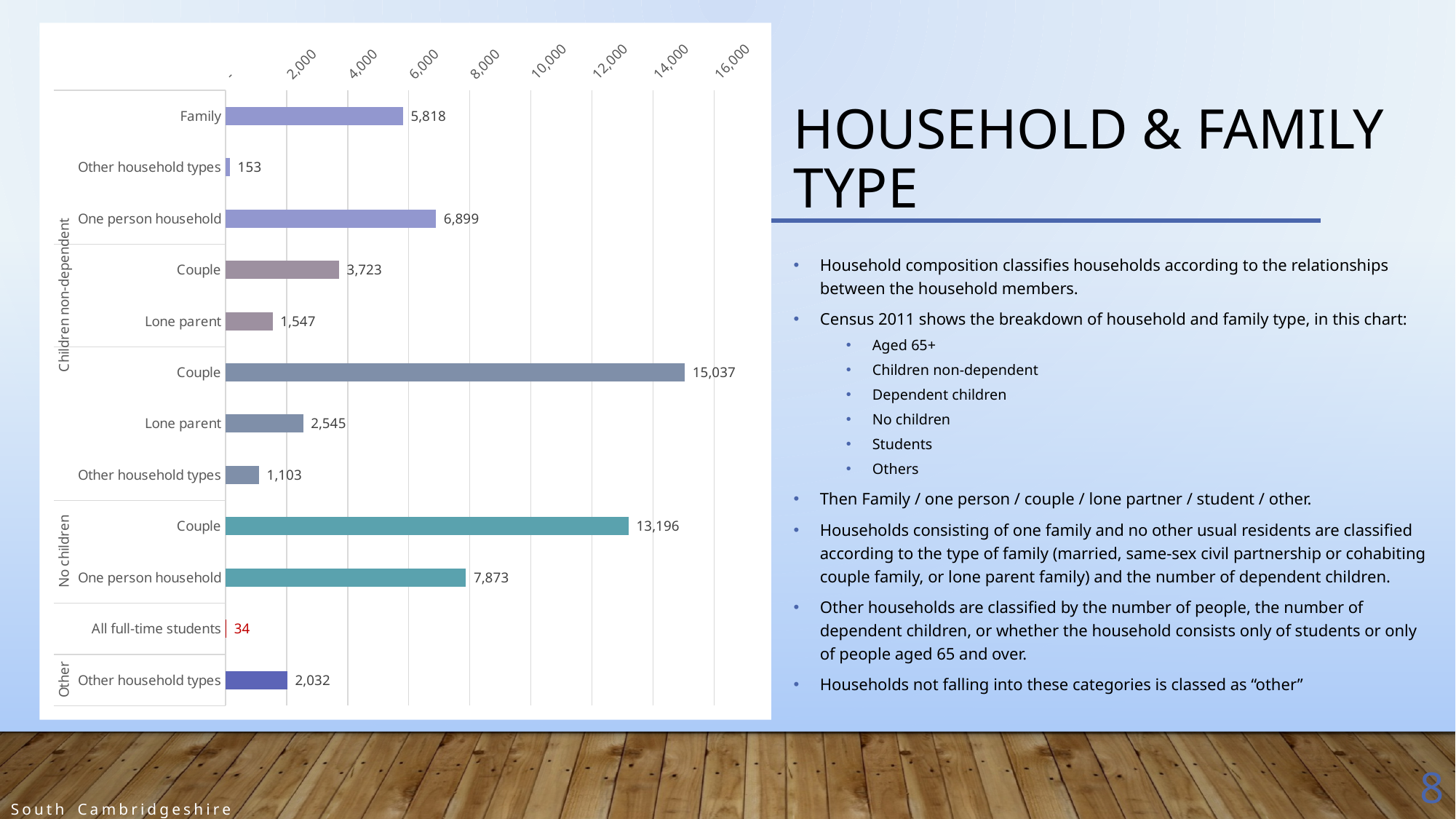
What is the difference between the Couple bar in the No children group (13,196) and the One person household bar in the No children group (7,873)? 5,323 Which bar has the highest value in the chart? Couple (15,037) Which bar has the lowest value in the chart? All full-time students How many bars are plotted in the chart? 12 What is the highest value shown on the chart's horizontal axis? 16,000 What is the value for the Other household types bar in the Other group? 2,032 What is the value for the One person household bar in the No children group? 7,873 What is the value for All full-time students? 34 What type of chart is shown on the slide? bar chart What is the value for the Couple bar in the No children group? 13,196 What is the value for the Lone parent bar in the Children non-dependent group? 1,547 Which is larger: the Couple bar in the Children non-dependent group or the Lone parent bar in the Children non-dependent group? Couple